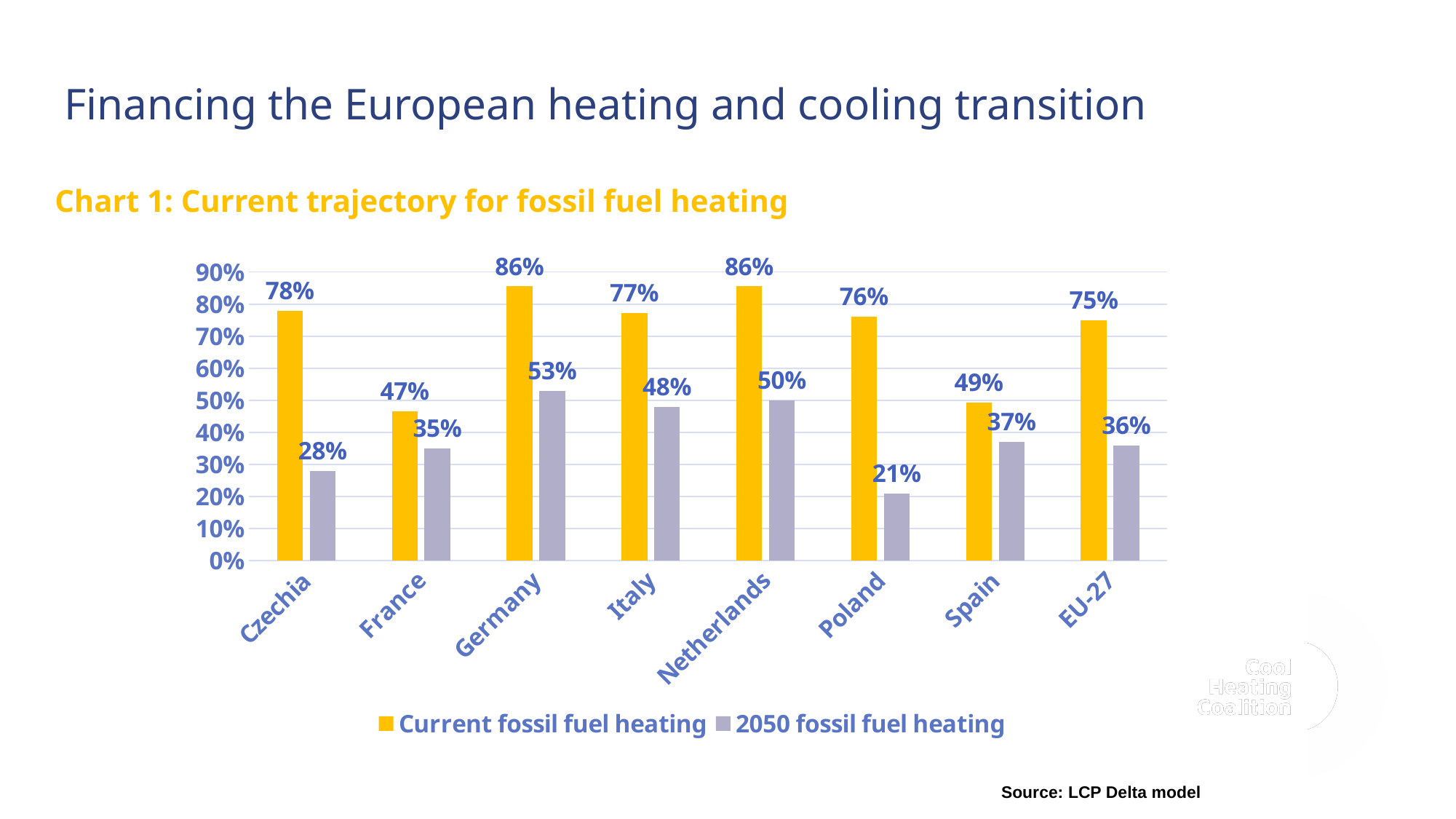
What is the 2050 fossil fuel heating value for EU-27? 36% What is the 2050 fossil fuel heating value for Poland? 21% Which is larger: the 2050 fossil fuel heating value for Spain or for France? Spain How many series does the legend list? 2 What is the difference between the current and 2050 fossil fuel heating values for Czechia? 50% What is the title of the chart? Chart 1: Current trajectory for fossil fuel heating Which country has the lowest current fossil fuel heating value? France Which category has the lowest 2050 fossil fuel heating value? Poland What kind of chart is shown on the slide? Bar chart How many categories are shown on the x axis? 8 What is the current fossil fuel heating value for Germany? 86% Which category has the highest 2050 fossil fuel heating value? Germany